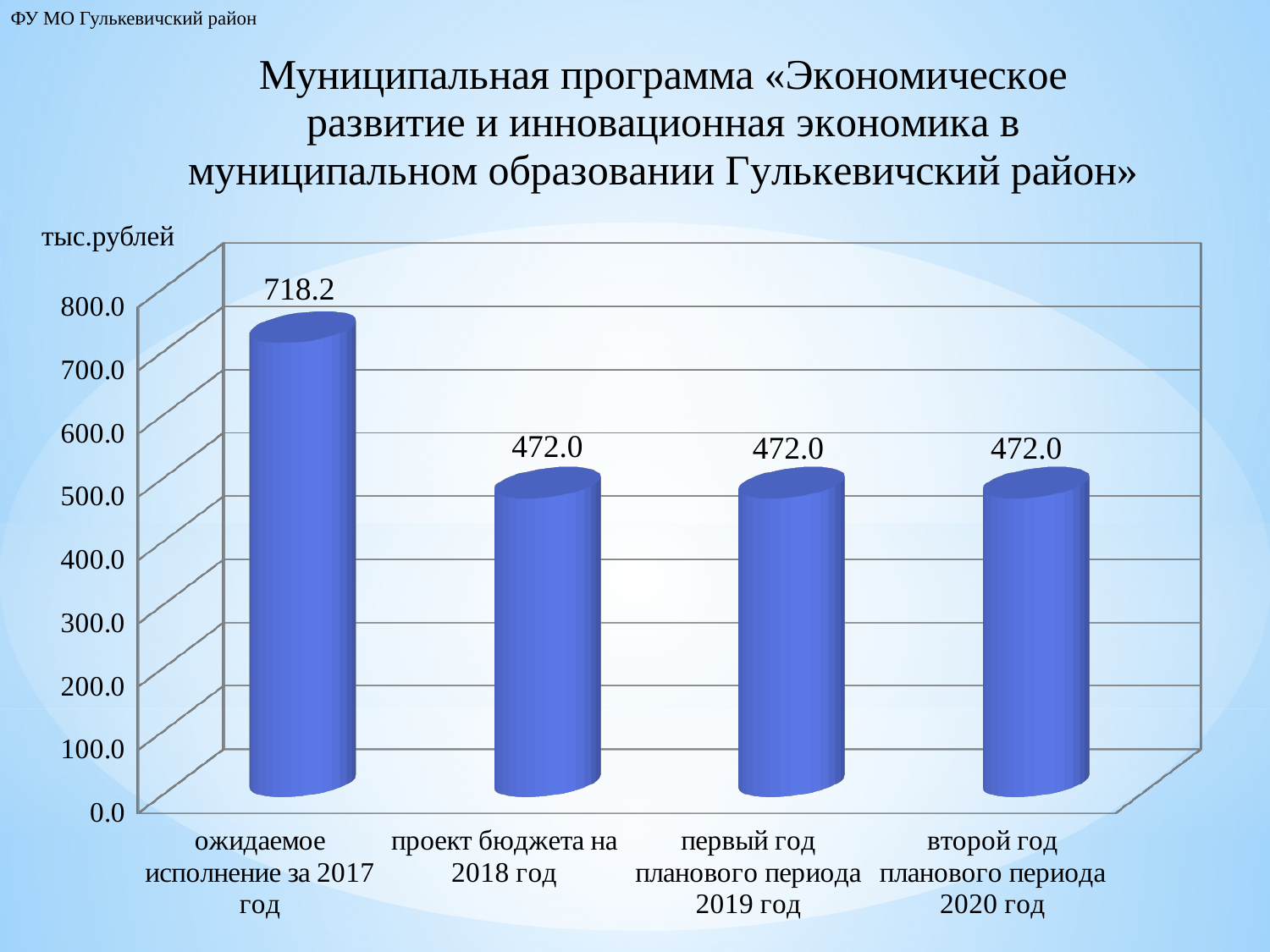
What is the value for «второй год планового периода 2020 год»? 472.0 How many categories are shown on the chart? 4 Is the value for «первый год планового периода 2019 год» greater or less than 500.0? less What unit is indicated above the vertical axis of the chart? тыс.рублей Which category has the highest value? ожидаемое исполнение за 2017 год What is the value for «ожидаемое исполнение за 2017 год»? 718.2 What is the value for «первый год планового периода 2019 год»? 472.0 What is the value for «проект бюджета на 2018 год»? 472.0 Which is larger: the value for «ожидаемое исполнение за 2017 год» or the value for «второй год планового периода 2020 год»? ожидаемое исполнение за 2017 год What kind of chart is shown on the slide? bar chart Is the value for «ожидаемое исполнение за 2017 год» greater or less than 700.0? greater What is the difference between the value for «ожидаемое исполнение за 2017 год» and the value for «проект бюджета на 2018 год»? 246.2